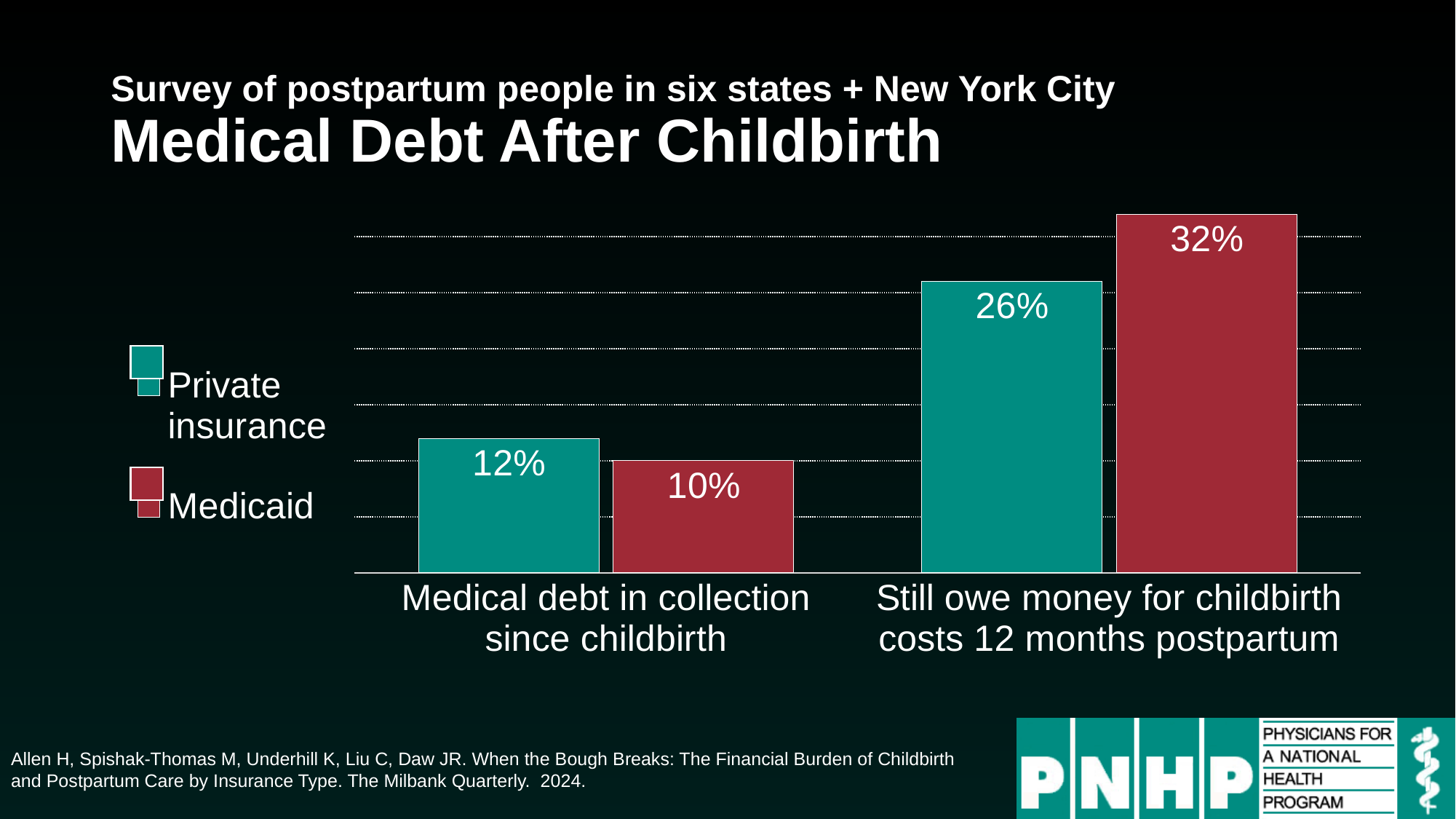
For medical debt in collection since childbirth, which is larger: private insurance or Medicaid? Private insurance What is the difference between Medicaid and private insurance for still owing money for childbirth costs 12 months postpartum? 6% What is the value for private insurance in the 'Still owe money for childbirth costs 12 months postpartum' category? 26% Which bar in the chart has the lowest value? Medicaid, medical debt in collection since childbirth How many categories are shown on the x axis of the chart? 2 What percentage of people with private insurance had medical debt in collection since childbirth? 12% How many series does the legend list? 2 What percentage of people on Medicaid still owe money for childbirth costs 12 months postpartum? 32% What is the difference between private insurance and Medicaid for medical debt in collection since childbirth? 2% What kind of chart is shown on the slide? Bar chart Which bar in the chart has the highest value? Medicaid, still owe money for childbirth costs 12 months postpartum What is the value for Medicaid in the 'Medical debt in collection since childbirth' category? 10%